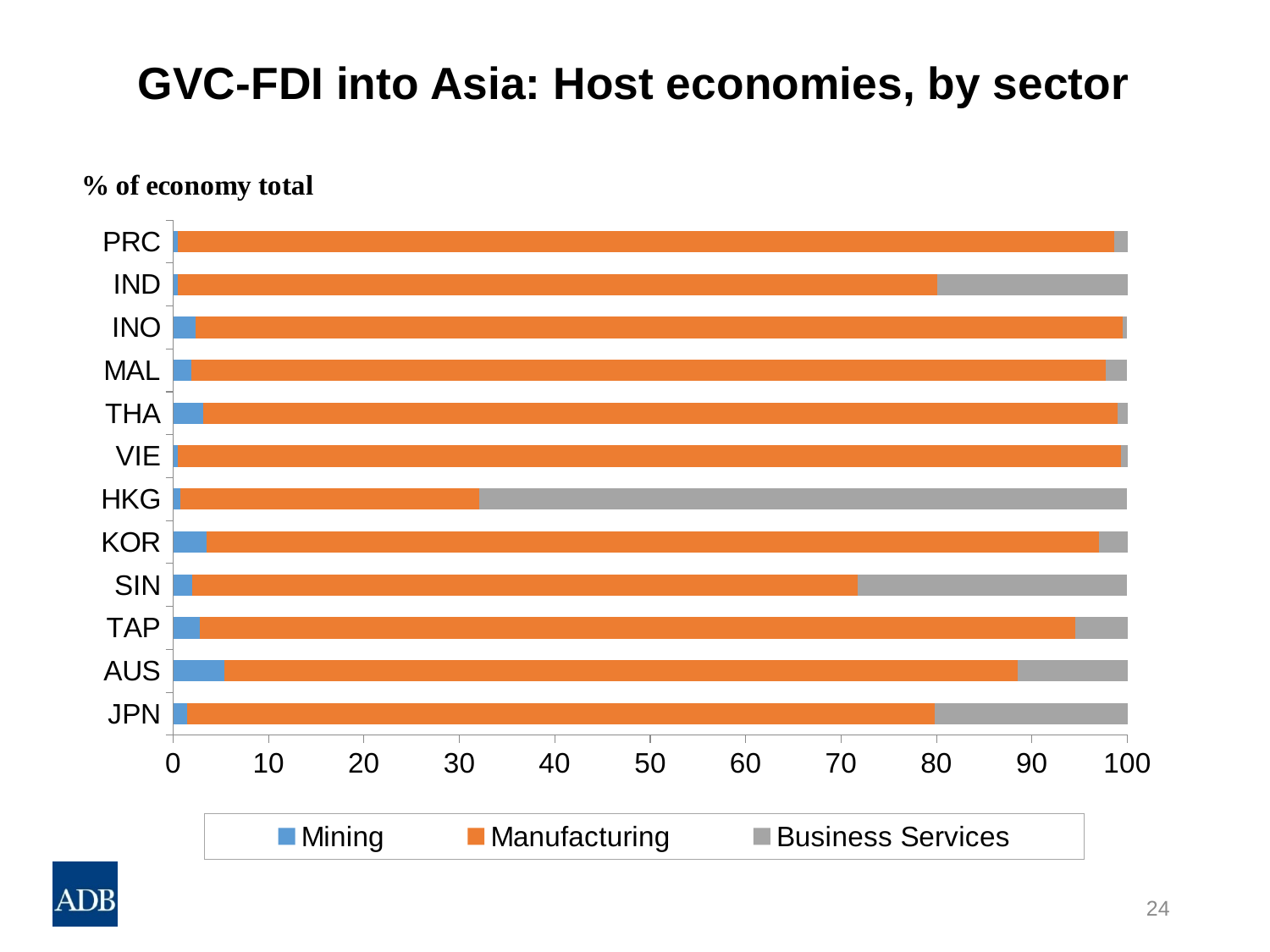
What is the total of the stacked bar for HKG? 100 Is the Manufacturing share for PRC greater or less than 90? greater How many series does the legend list? 3 What kind of chart is shown on the slide? Stacked bar chart Which has the larger Mining share, AUS or PRC? AUS What is the title of the chart on the slide? GVC-FDI into Asia: Host economies, by sector Is the Manufacturing share for HKG greater or less than 40? less Which economy has the smallest Manufacturing share? HKG Which economy has the largest Business Services share? HKG Which has the larger Business Services share, HKG or SIN? HKG How many economies are listed on the vertical axis of the chart? 12 Which economy has the largest Mining share? AUS